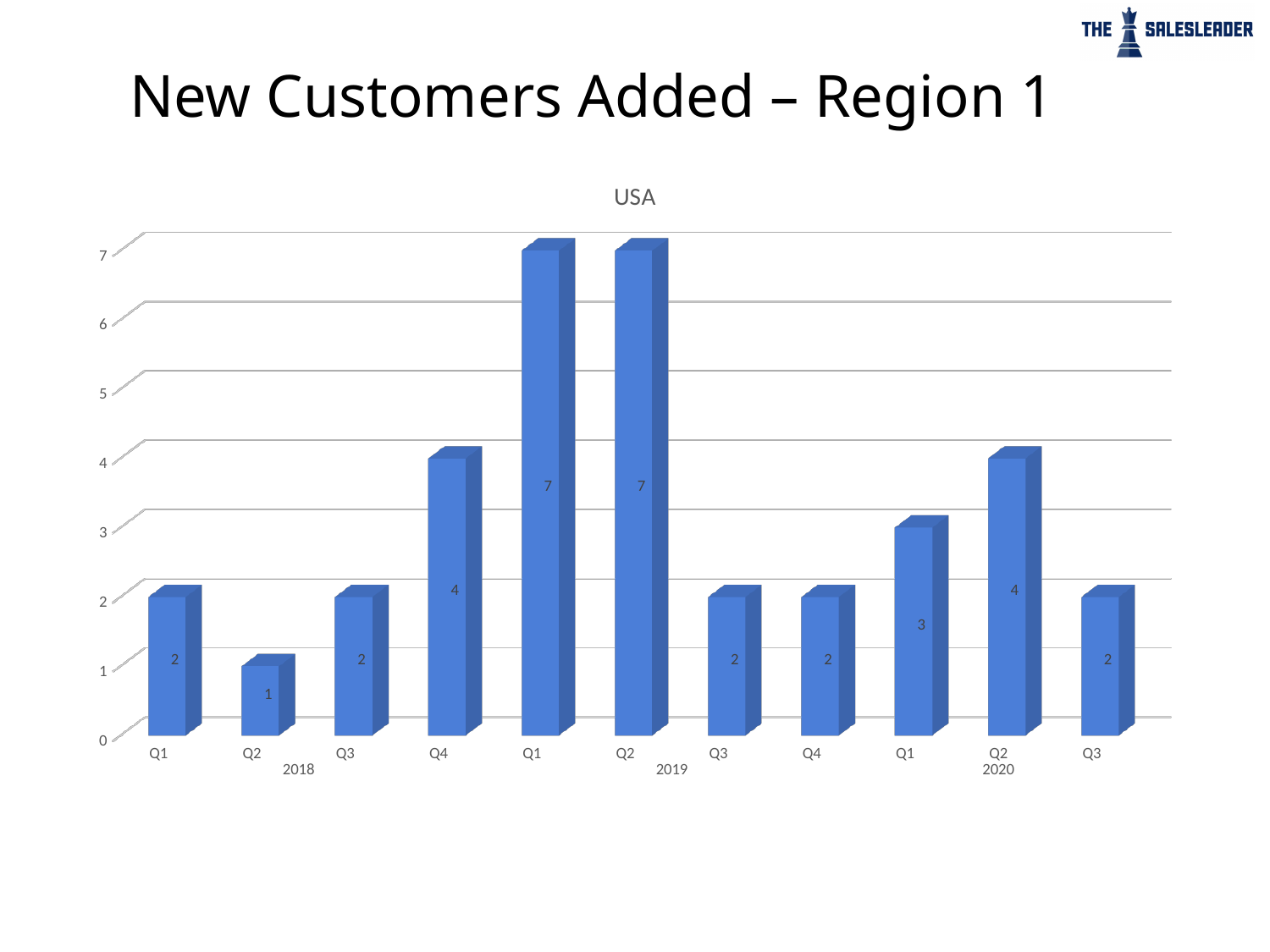
What is the value for Q1 2020? 3 Which quarter has the lowest value? Q2 2018 What kind of chart is this? bar chart What is the value for Q3 2020? 2 Which is larger, the value for Q2 2020 or the value for Q1 2020? Q2 2020 How many quarters are shown on the x axis? 11 What is the difference between the values for Q1 2019 and Q4 2018? 3 What is the title shown above the chart? USA What is the value for Q4 2018? 4 What is the highest value shown on the chart? 7 What is the value for Q2 2018? 1 Do the values rise or fall from Q2 2019 to Q3 2019? fall